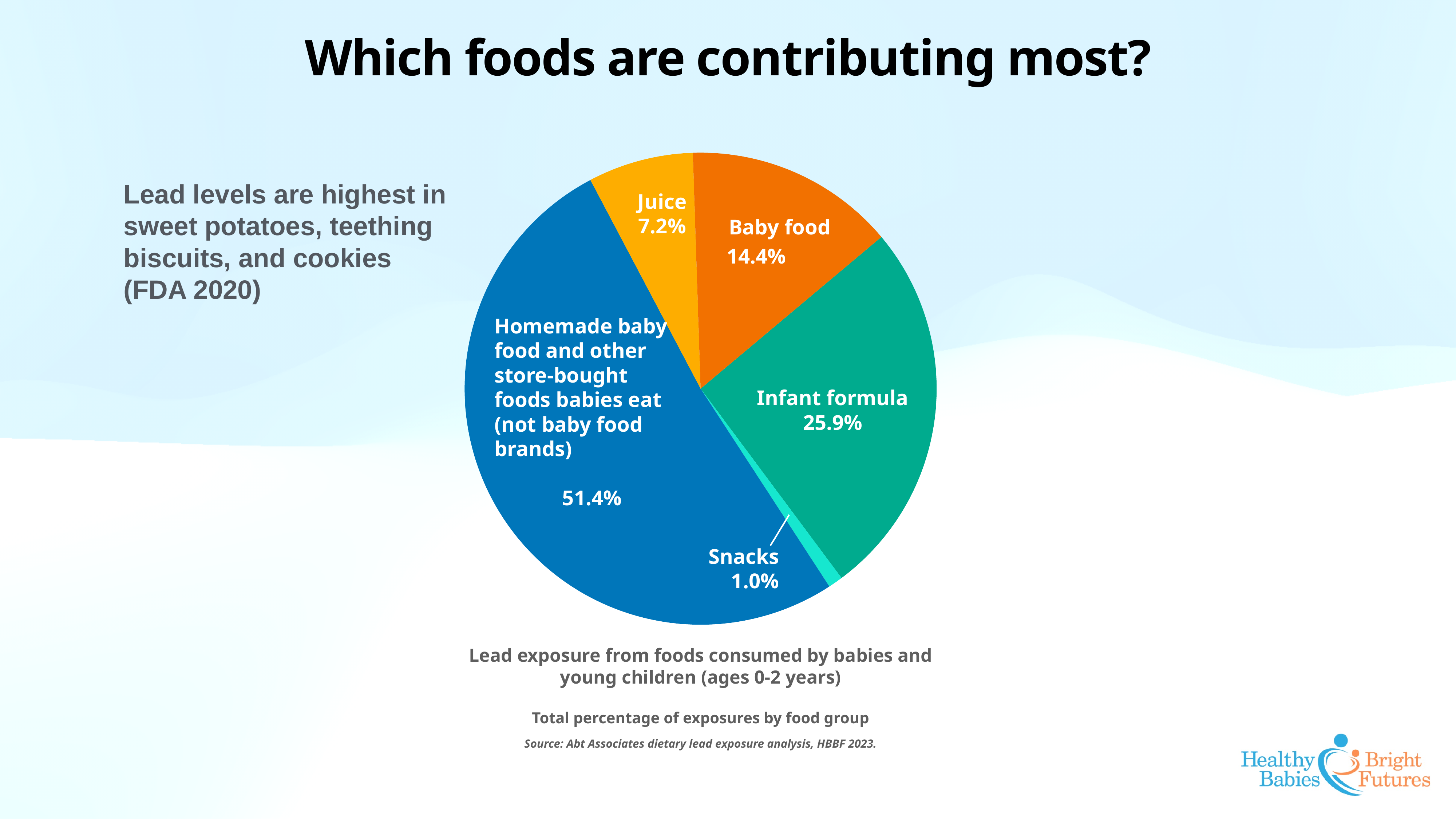
How many food groups are shown in the pie chart? 5 Which food group contributes the smallest share of lead exposure? Snacks What percentage of lead exposure comes from snacks? 1.0% What is the caption below the pie chart? Lead exposure from foods consumed by babies and young children (ages 0-2 years) What percentage of lead exposure comes from juice? 7.2% Which food group contributes the largest share of lead exposure? Homemade baby food and other store-bought foods babies eat (not baby food brands) What kind of chart is shown on the slide? Pie chart Which contributes more to lead exposure, juice or baby food? Baby food What is the difference in percentage points between infant formula and baby food? 11.5 What percentage of lead exposure comes from baby food? 14.4% What percentage of lead exposure comes from homemade baby food and other store-bought foods babies eat (not baby food brands)? 51.4% What percentage of lead exposure comes from infant formula? 25.9%